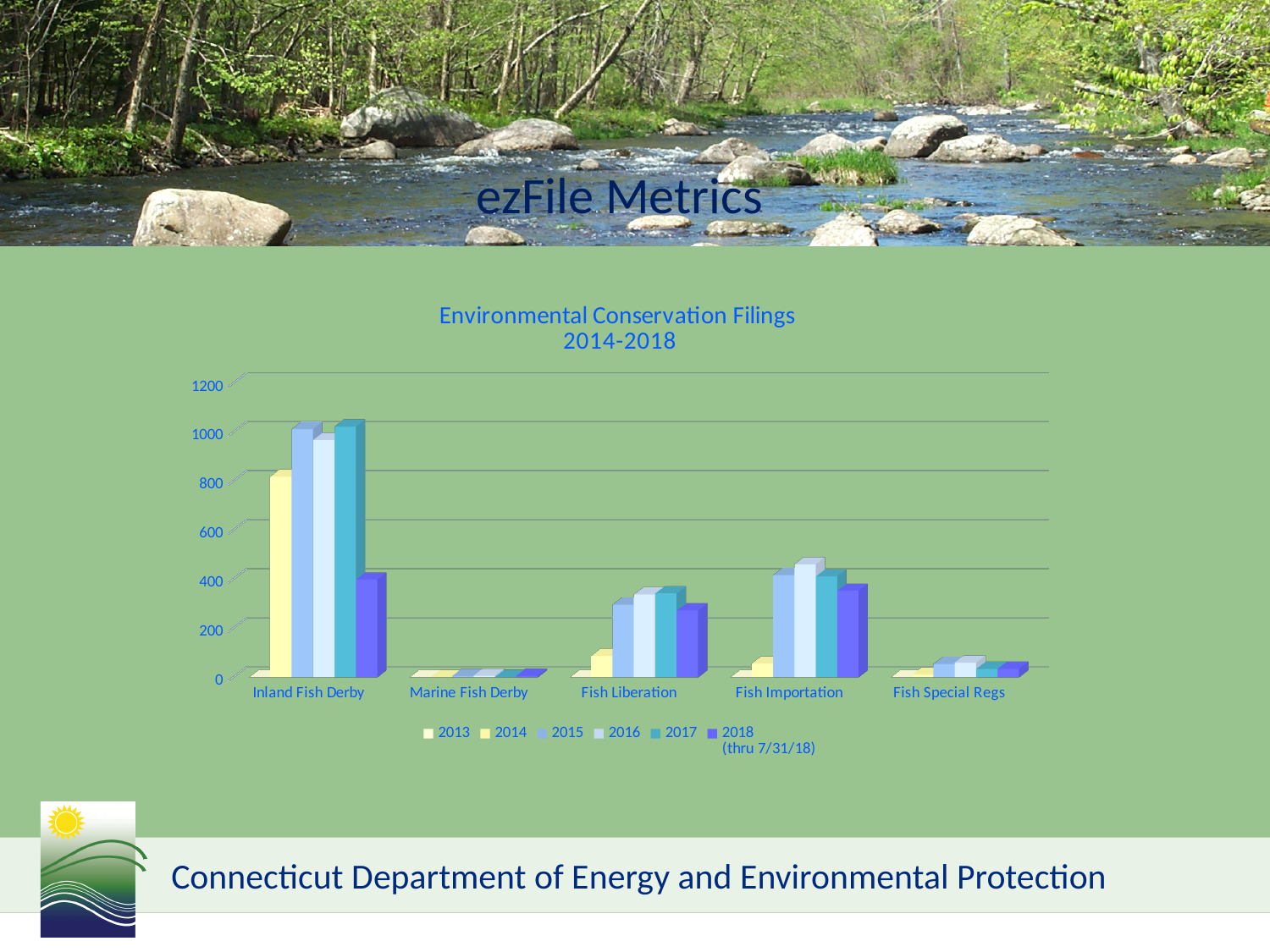
Which category has the highest filings in the chart? Inland Fish Derby Which category has the lowest filings in the chart? Marine Fish Derby Which is larger, the 2015 value for Inland Fish Derby or the 2015 value for Fish Importation? Inland Fish Derby What is the title of the chart? Environmental Conservation Filings 2014-2018 Is the 2014 value for Inland Fish Derby greater or less than 600? greater What kind of chart is shown on the slide? bar chart Is the 2015 value for Fish Liberation greater or less than 400? less How many categories are shown on the x axis of the chart? 5 Is the 2016 value for Fish Importation greater or less than 200? greater Which is larger, the 2016 value for Fish Importation or the 2016 value for Fish Special Regs? Fish Importation How many series does the chart's legend list? 6